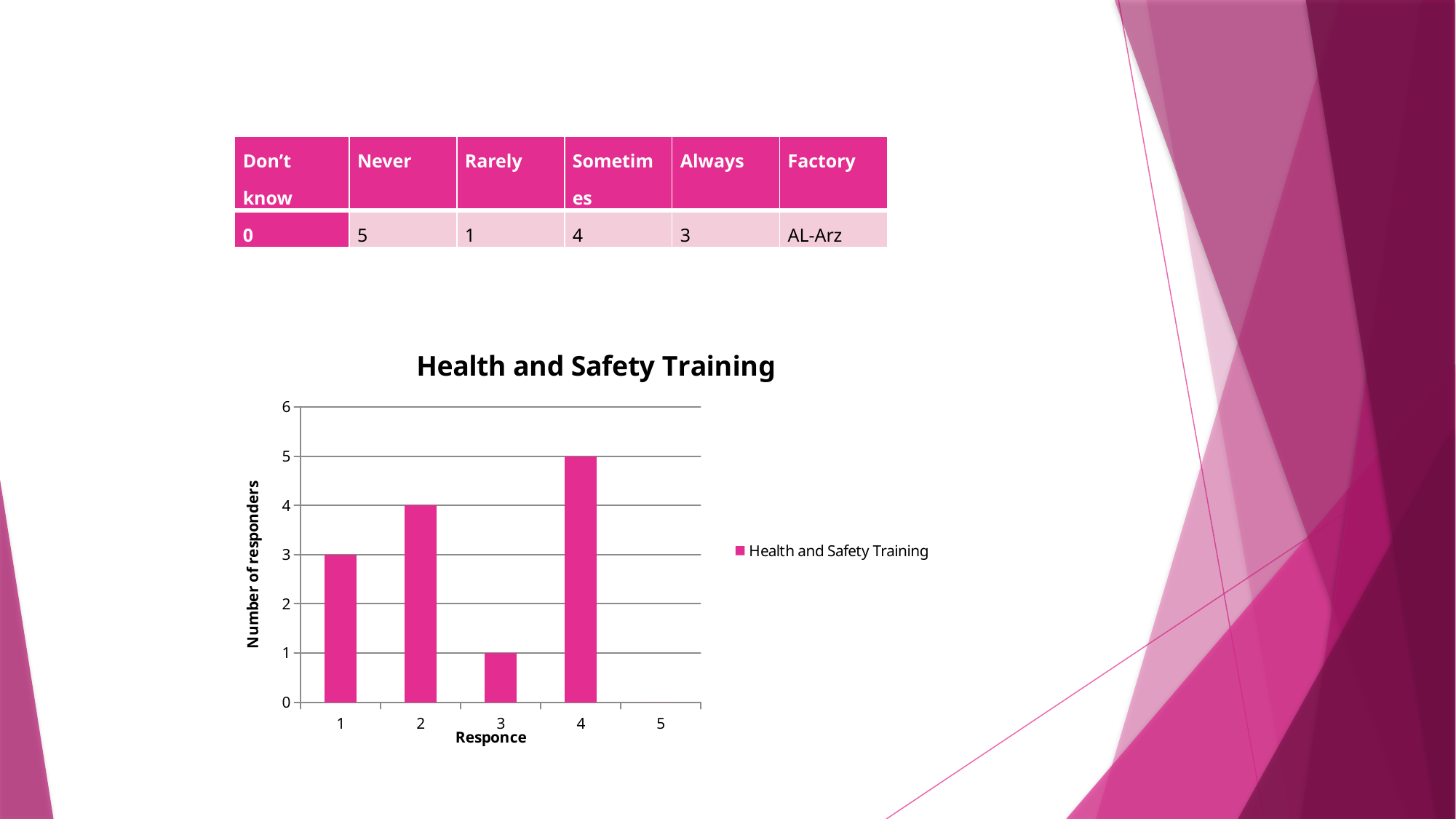
What is the label of the vertical axis? Number of responders What is the difference in number of responders between response 4 and response 2? 1 Which response has the highest number of responders? 4 How many response categories are shown on the x axis? 5 Which has more responders, response 1 or response 2? 2 What is the number of responders for response 3? 1 What is the title of the chart? Health and Safety Training How many series does the chart legend list? 1 Which response has the lowest number of responders? 5 What is the number of responders for response 4? 5 What is the number of responders for response 1? 3 What type of chart is shown on the slide? bar chart